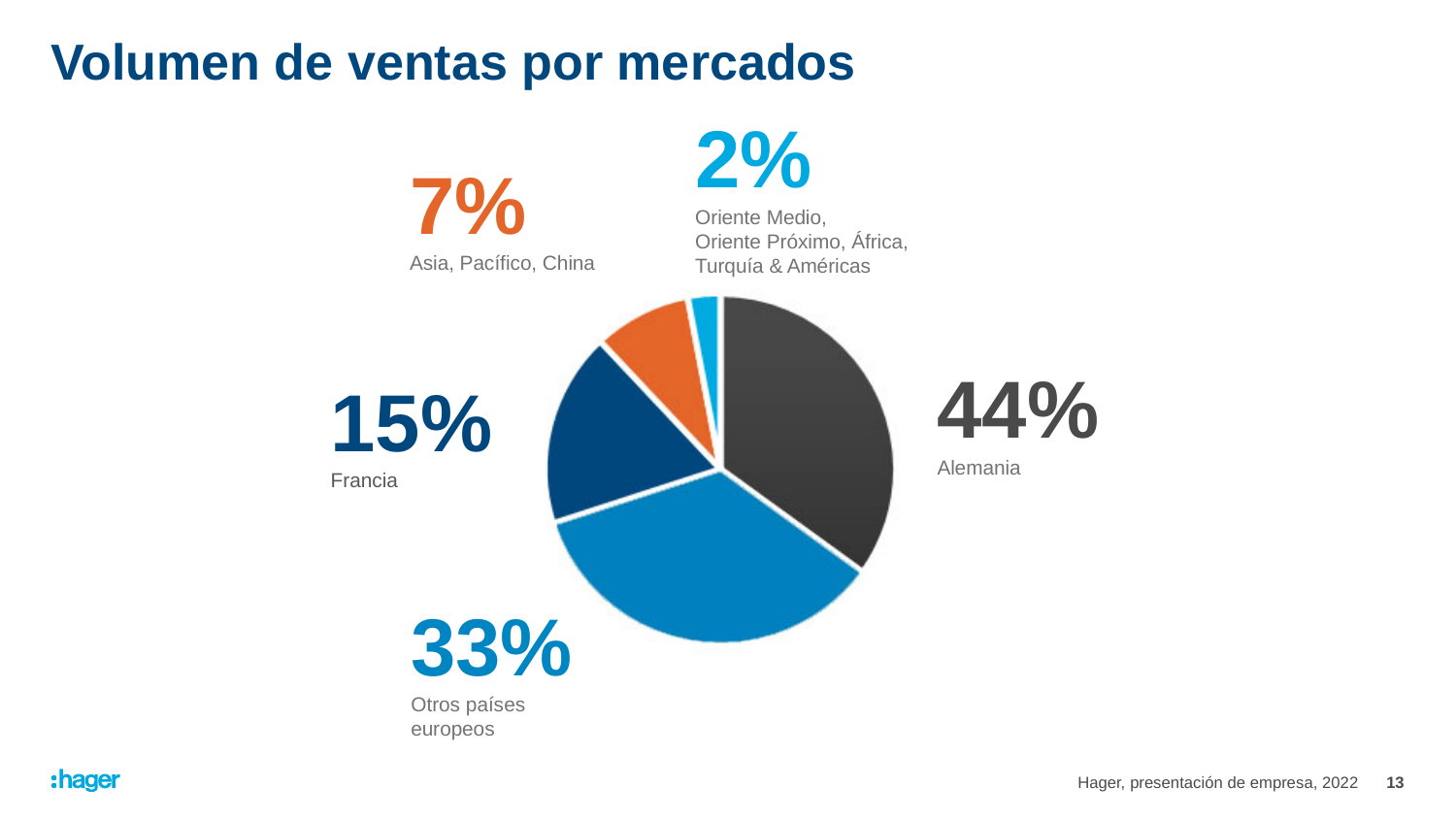
Which market has the smallest share of sales volume? Oriente Medio, Oriente Próximo, África, Turquía & Américas What share of sales volume does Oriente Medio, Oriente Próximo, África, Turquía & Américas account for? 2% What share of sales volume does Asia, Pacífico, China account for? 7% Which has a larger share of sales volume, Francia or Asia, Pacífico, China? Francia What share of sales volume does Francia account for? 15% What share of sales volume do Otros países europeos account for? 33% Which market has the largest share of sales volume? Alemania What share of sales volume does Alemania account for? 44% How many market segments are shown in the pie chart? 5 What is the title of the slide containing the chart? Volumen de ventas por mercados What is the difference in percentage points between Alemania and Otros países europeos? 11 What kind of chart is shown on the slide? Pie chart